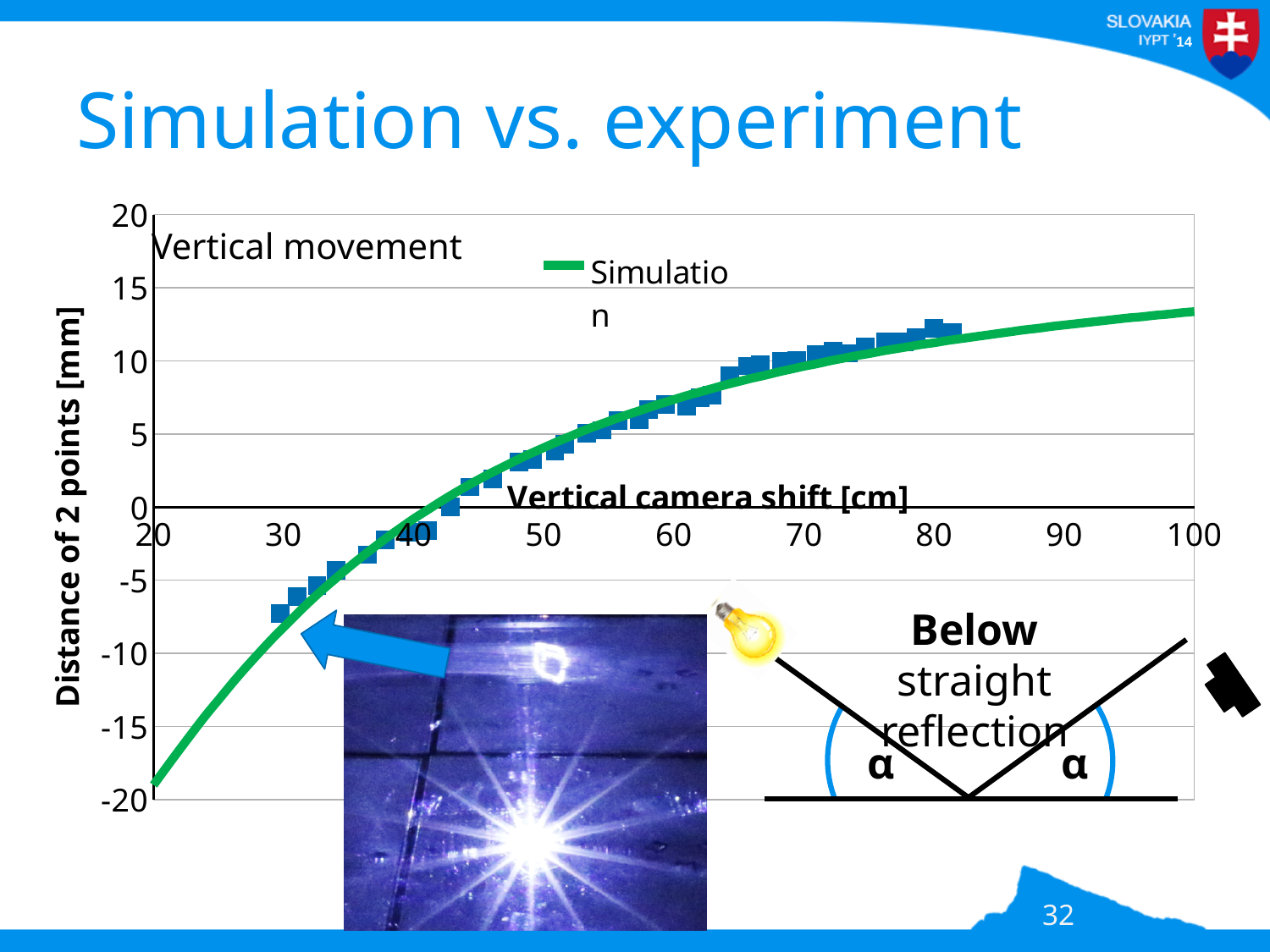
Is the simulation value at a vertical camera shift of 50 cm greater or less than 0? greater Is the simulation value at a vertical camera shift of 30 cm greater or less than 0? less What is the label of the x axis? Vertical camera shift [cm] What is the title of the chart? Vertical movement What kind of chart is shown on the slide? line chart with scatter points Which is larger, the simulation value at 40 cm or at 70 cm? 70 cm Is the simulation value at a vertical camera shift of 20 cm greater or less than -15? less Do the values rise or fall as the vertical camera shift increases from 20 to 100 cm? rise How many series does the legend list? 1